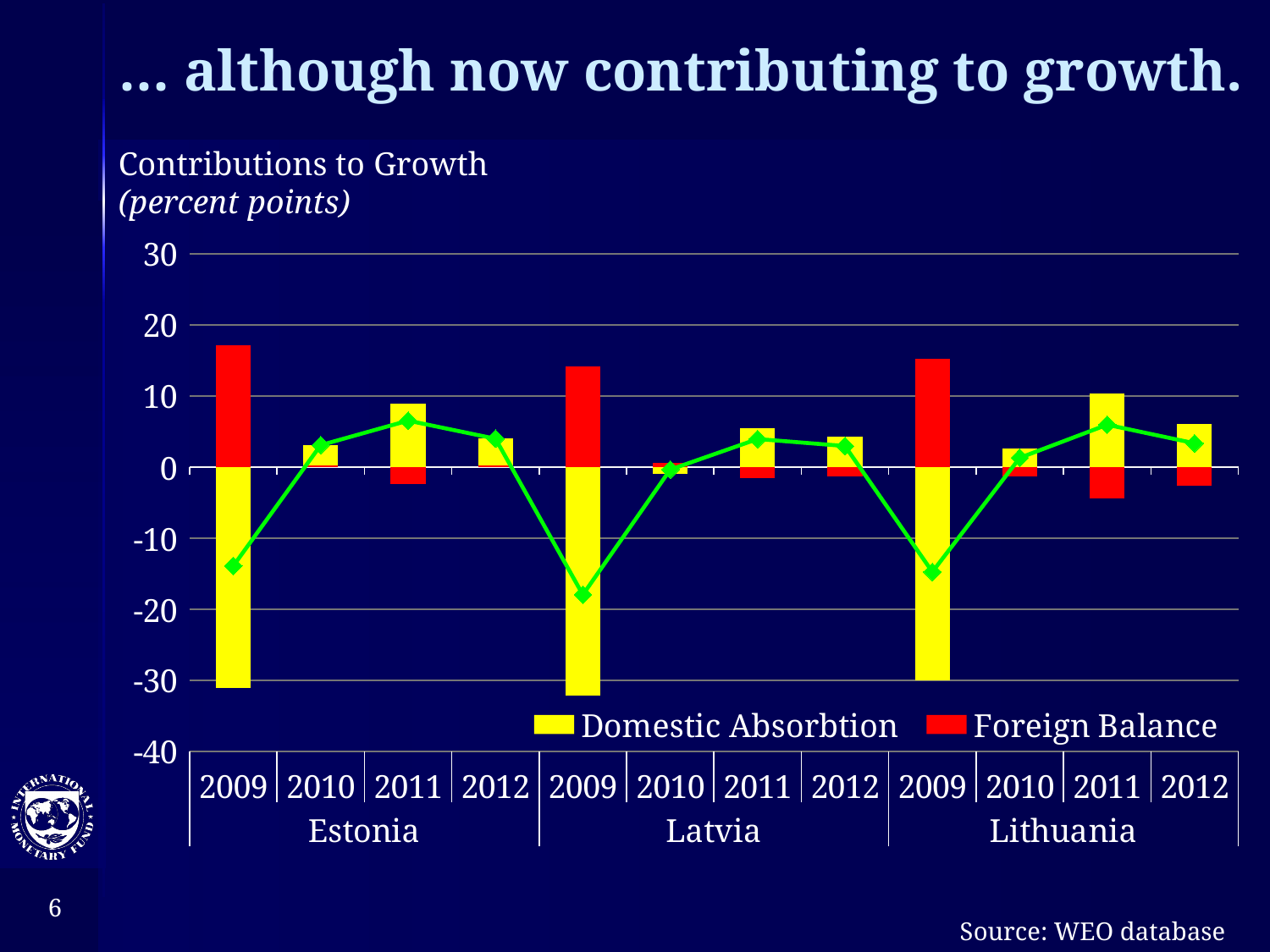
Is the Domestic Absorbtion value for Latvia in 2011 greater or less than 10? less What kind of chart is shown on the slide? combination bar and line chart How many countries are shown on the x axis of the chart? 3 What colour represents Foreign Balance in the chart? red Does the Domestic Absorbtion value for Estonia rise or fall from 2009 to 2011? rise Which is larger, the Foreign Balance for Estonia in 2009 or the Foreign Balance for Latvia in 2009? Estonia 2009 How many series does the chart legend list? 2 Is the Foreign Balance value for Estonia in 2009 greater or less than 10? greater Is the Domestic Absorbtion value for Estonia in 2009 greater or less than -20? less Which country-year has the highest Foreign Balance value? Estonia 2009 How many years are shown for each country on the x axis? 4